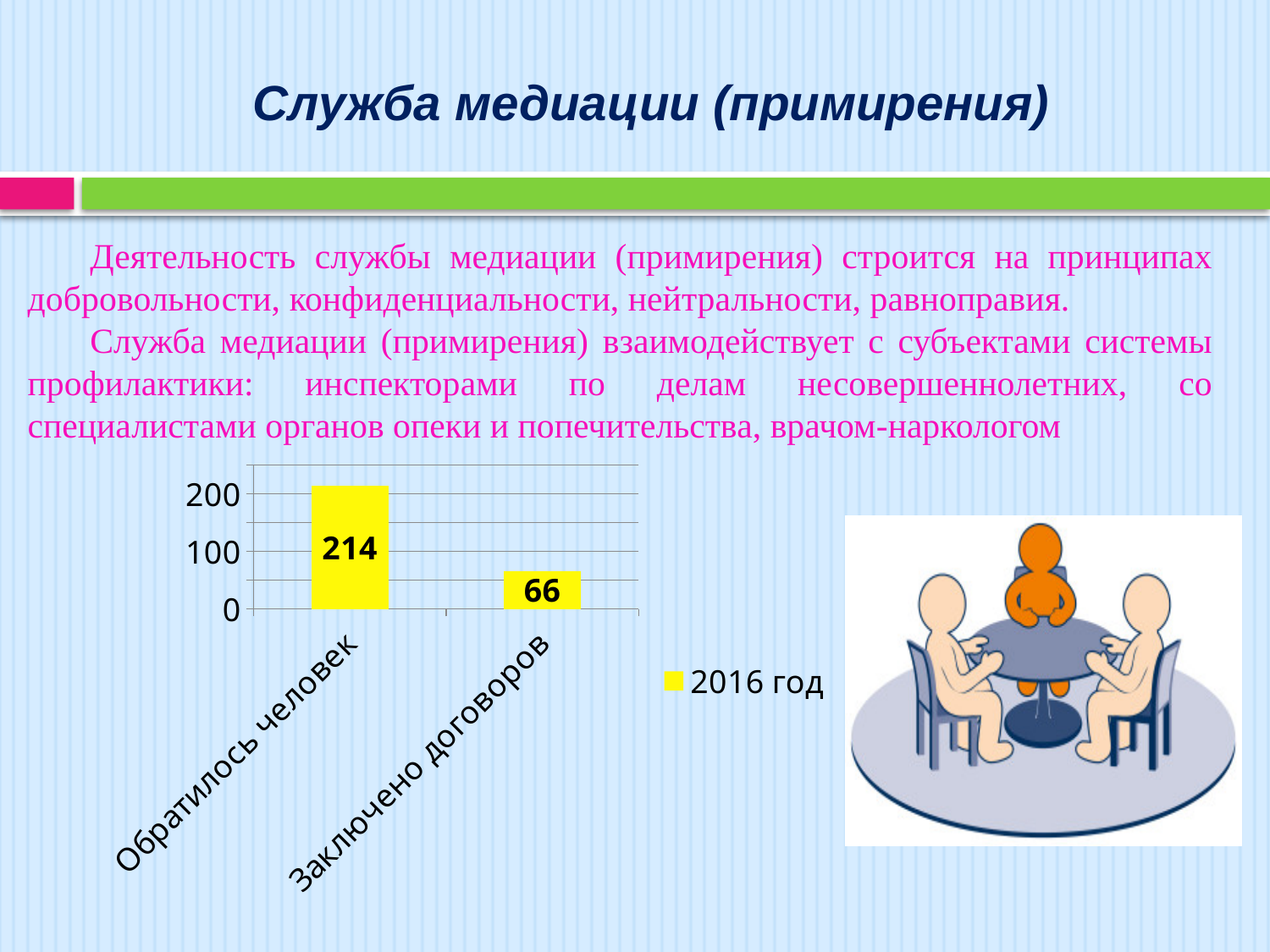
Is the value for "Обратилось человек" greater or less than 200? greater Which category has the highest value? Обратилось человек How many categories are shown on the chart? 2 What is the difference between the values for "Обратилось человек" and "Заключено договоров"? 148 What is the value for "Обратилось человек"? 214 Which is larger: the value for "Обратилось человек" or for "Заключено договоров"? Обратилось человек What is the value for "Заключено договоров"? 66 How many series does the legend list? 1 Which category has the lowest value? Заключено договоров What kind of chart is shown on the slide? bar chart Is the value for "Заключено договоров" greater or less than 100? less What series name is shown in the chart legend? 2016 год